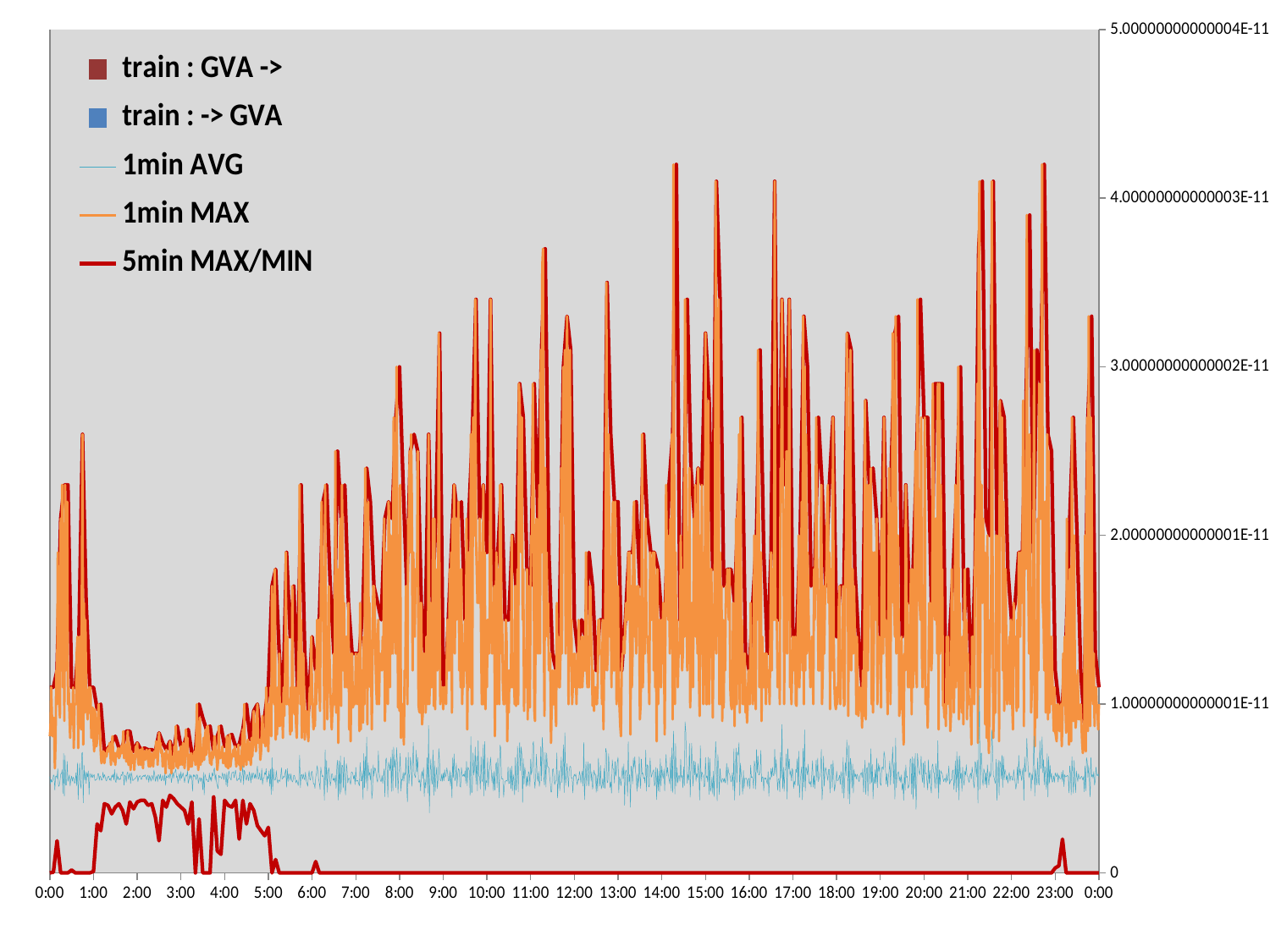
Is the highest peak of the 5min MAX/MIN line greater or less than 4.00000000000003E-11? greater What is the highest value shown on the y axis? 5.00000000000004E-11 Is the 1min MAX value at 3:00 greater or less than 2.00000000000001E-11? less How many time labels are shown along the x axis? 25 What kind of chart is shown on the slide? line chart Is the highest peak of the 5min MAX/MIN line greater or less than 5.00000000000004E-11? less Are the 1min MAX values between 1:00 and 5:00 higher or lower than those between 10:00 and 22:00? lower Which legend entry is drawn with the thick dark red line? 5min MAX/MIN What is the first entry in the legend? train : GVA -> How many entries does the legend list? 5 What is the lowest value shown on the y axis? 0